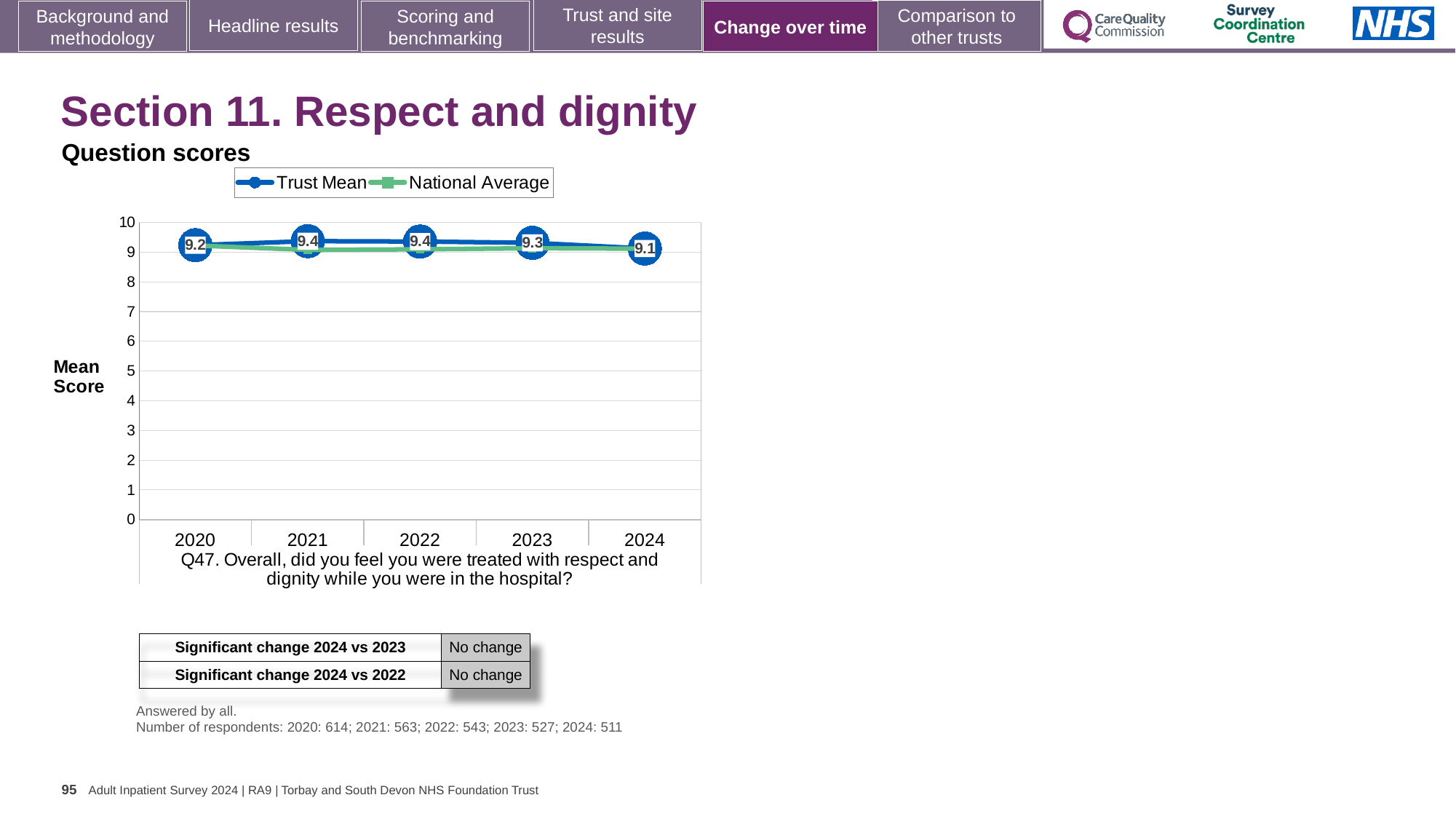
In which year is the Trust Mean lowest? 2024 How many series does the legend list? 2 How many years are shown on the x axis? 5 Which is larger, the Trust Mean in 2022 or in 2024? 2022 What kind of chart is shown? Line chart Does the Trust Mean rise or fall from 2022 to 2024? Fall Is the National Average value for 2024 greater or less than 8? greater What is the Trust Mean for 2023? 9.3 What is the Trust Mean for 2020? 9.2 What is the difference between the Trust Mean in 2021 and in 2024? 0.3 What is the Trust Mean for 2024? 9.1 What is the label on the y axis? Mean Score